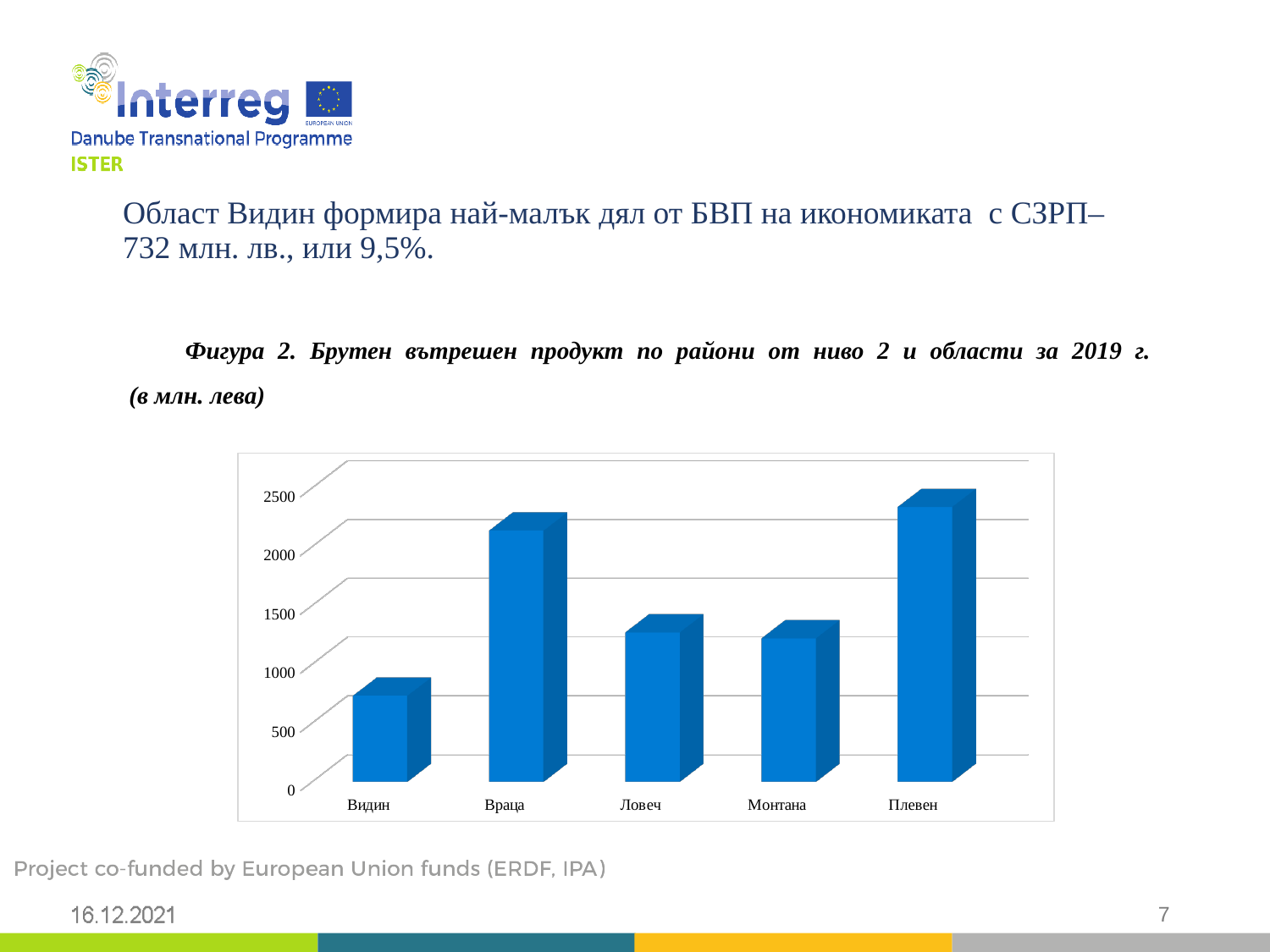
Is the value for Враца greater or less than 2000? greater What is the highest tick value shown on the vertical axis of the chart? 2500 Which region has the lowest bar in the chart? Видин Which region has the highest bar in the chart? Плевен Which has the larger value, Плевен or Враца? Плевен Which has the larger value, Враца or Ловеч? Враца How many regions (categories) are shown on the x axis of the chart? 5 Is the value for Плевен greater or less than 2000? greater Is the value for Ловеч greater or less than 1500? less What kind of chart is shown on the slide? bar chart